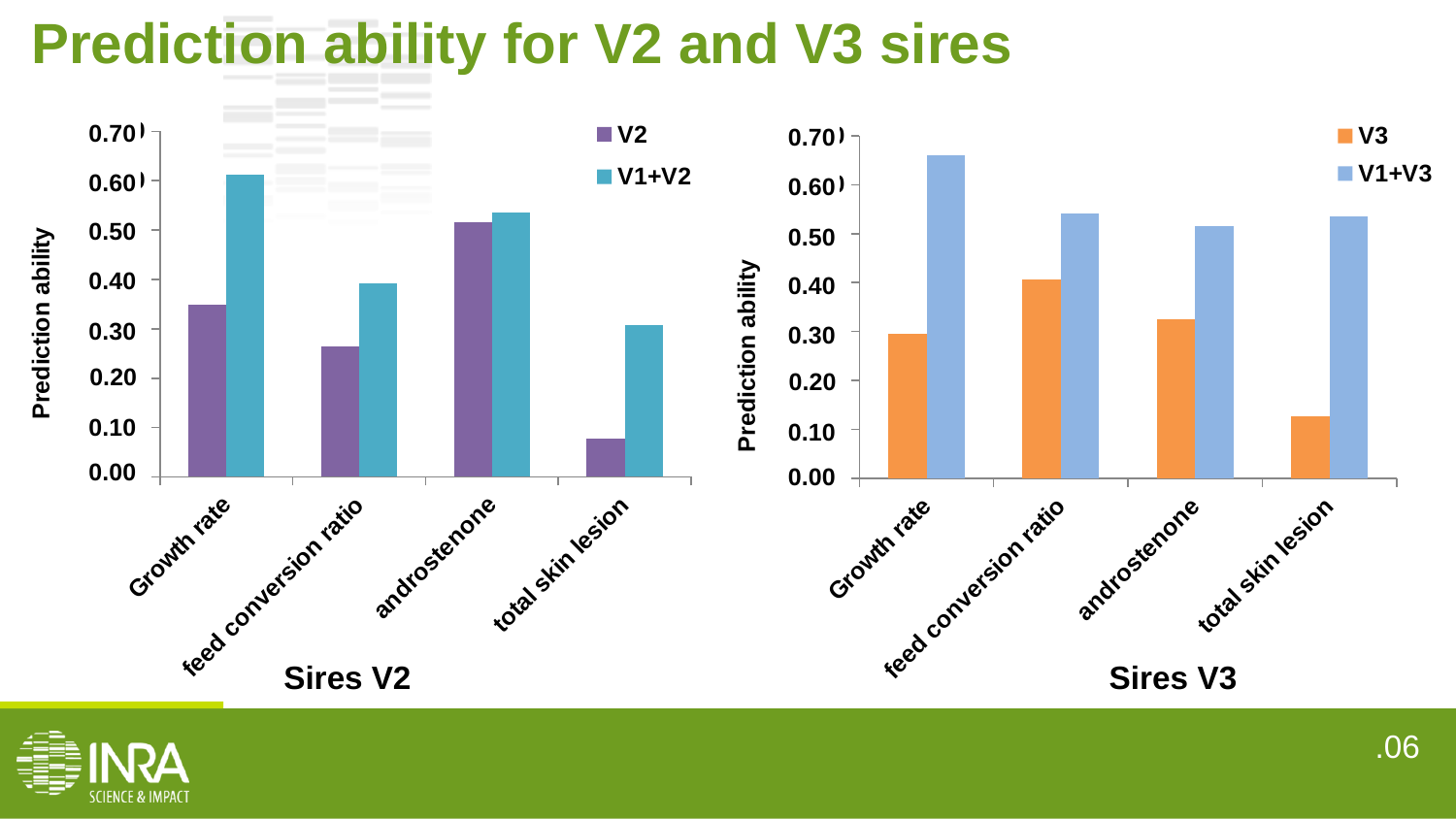
In the Sires V3 chart, which category has the highest V3 value? feed conversion ratio In the Sires V2 chart, which category has the highest V2 value? androstenone In the Sires V3 chart, is the V1+V3 value for Growth rate greater or less than 0.60? greater What are the two legend entries of the Sires V3 chart? V3 and V1+V3 In the Sires V2 chart, is the V1+V2 value for Growth rate greater or less than 0.50? greater How many series does the legend of the Sires V2 chart list? 2 In the Sires V2 chart, is the V2 value for total skin lesion greater or less than 0.10? less In the Sires V2 chart, which category has the lowest V2 value? total skin lesion What kind of chart is the Sires V2 chart on the left? bar chart In the Sires V3 chart, which category has the highest V1+V3 value? Growth rate How many categories are shown on the x axis of the Sires V2 chart? 4 In the Sires V3 chart, which is larger for total skin lesion: V3 or V1+V3? V1+V3